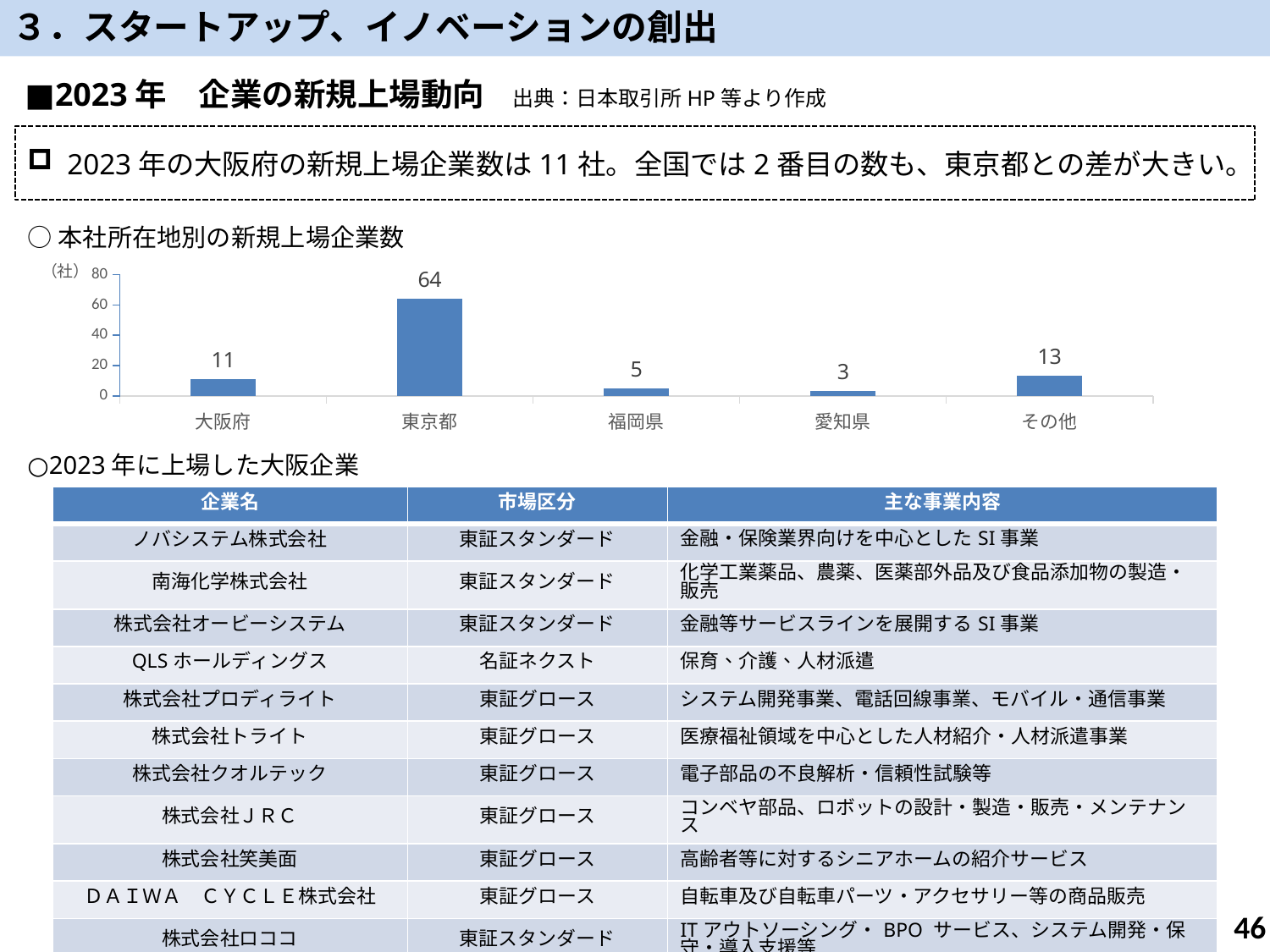
What is the difference between the values for 福岡県 and 愛知県 in the chart 本社所在地別の新規上場企業数? 2 What is the value for その他 in the chart 本社所在地別の新規上場企業数? 13 What kind of chart is 本社所在地別の新規上場企業数? bar chart Is the value for 東京都 in the chart 本社所在地別の新規上場企業数 greater or less than 60? greater What is the difference between the values for 東京都 and 大阪府 in the chart 本社所在地別の新規上場企業数? 53 Which category has the highest value in the chart 本社所在地別の新規上場企業数? 東京都 What is the value for 大阪府 in the chart 本社所在地別の新規上場企業数? 11 How many categories are shown in the chart 本社所在地別の新規上場企業数? 5 Which is larger in the chart 本社所在地別の新規上場企業数, the value for 大阪府 or the value for その他? その他 What is the value for 愛知県 in the chart 本社所在地別の新規上場企業数? 3 What is the value for 東京都 in the chart 本社所在地別の新規上場企業数? 64 Which category has the lowest value in the chart 本社所在地別の新規上場企業数? 愛知県